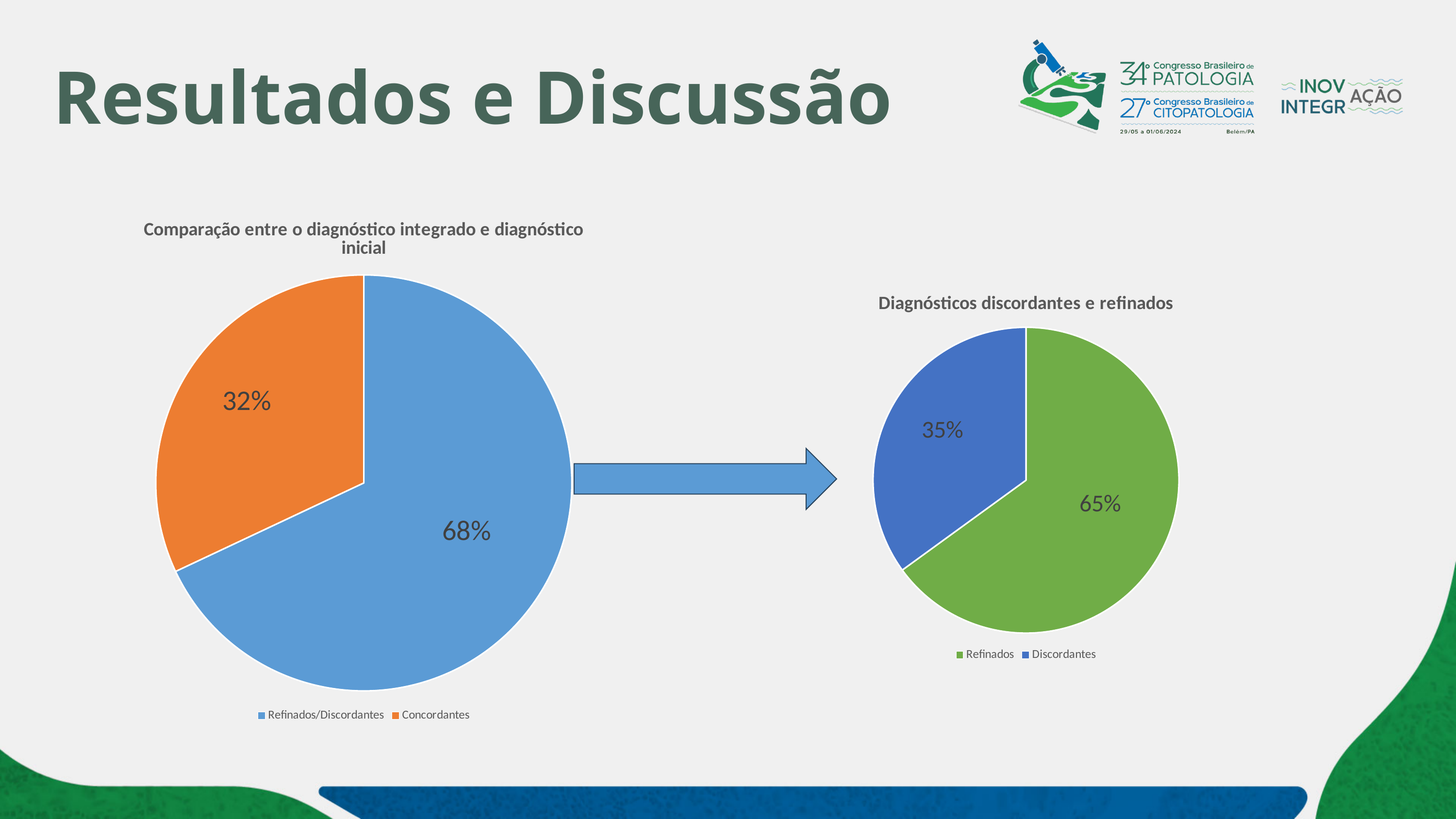
In the chart titled "Diagnósticos discordantes e refinados", what is the difference in percentage points between Refinados and Discordantes? 30 What type of chart is the chart titled "Comparação entre o diagnóstico integrado e diagnóstico inicial"? Pie chart In the chart titled "Diagnósticos discordantes e refinados", what percentage is shown for Discordantes? 35% In the chart titled "Diagnósticos discordantes e refinados", what percentage is shown for Refinados? 65% In the chart titled "Comparação entre o diagnóstico integrado e diagnóstico inicial", what percentage is shown for Concordantes? 32% In the chart titled "Comparação entre o diagnóstico integrado e diagnóstico inicial", what colour is the Concordantes slice? Orange In the chart titled "Diagnósticos discordantes e refinados", which category has the smallest slice? Discordantes How many categories does the legend of the chart titled "Diagnósticos discordantes e refinados" list? 2 In the chart titled "Comparação entre o diagnóstico integrado e diagnóstico inicial", what percentage is shown for Refinados/Discordantes? 68% In the chart titled "Diagnósticos discordantes e refinados", which is larger, Refinados or Discordantes? Refinados In the chart titled "Comparação entre o diagnóstico integrado e diagnóstico inicial", which category has the largest slice? Refinados/Discordantes In the chart titled "Comparação entre o diagnóstico integrado e diagnóstico inicial", what is the difference in percentage points between Refinados/Discordantes and Concordantes? 36